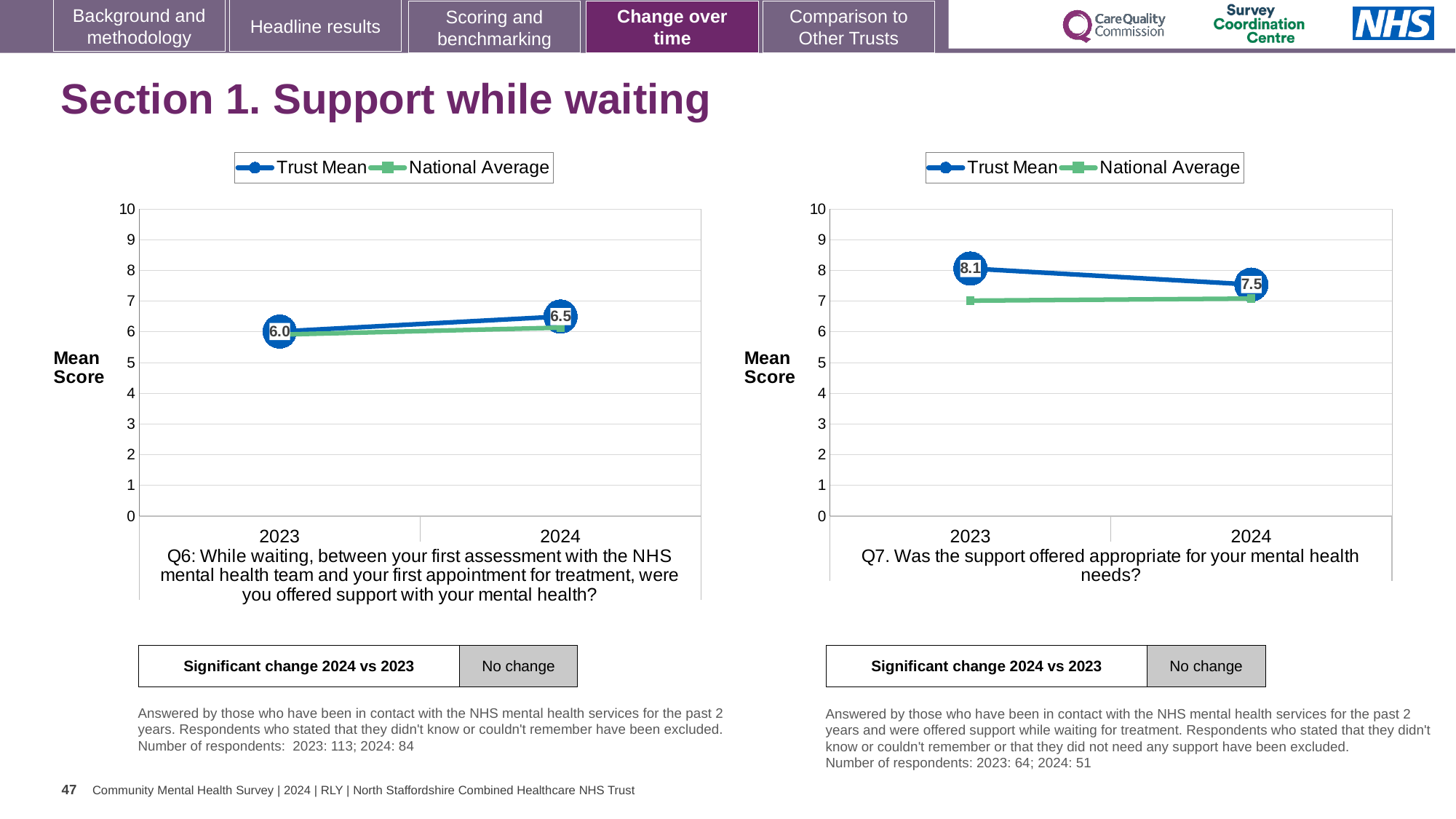
In the right chart (Q7), does the Trust Mean rise or fall from 2023 to 2024? fall In the left chart (Q6), what is the Trust Mean for 2023? 6.0 In the right chart (Q7), what is the Trust Mean for 2024? 7.5 In the right chart (Q7), which is larger in 2023, the Trust Mean or the National Average? Trust Mean What kind of chart is the right chart (Q7)? line chart In the right chart (Q7), is the National Average for 2023 greater or less than 8? less In the right chart (Q7), what is the difference between the Trust Mean in 2023 and 2024? 0.6 How many series does the legend of the left chart (Q6) list? 2 In the left chart (Q6), what is the Trust Mean for 2024? 6.5 In the right chart (Q7), what is the Trust Mean for 2023? 8.1 In the left chart (Q6), does the Trust Mean rise or fall from 2023 to 2024? rise In the left chart (Q6), by how much did the Trust Mean change from 2023 to 2024? 0.5